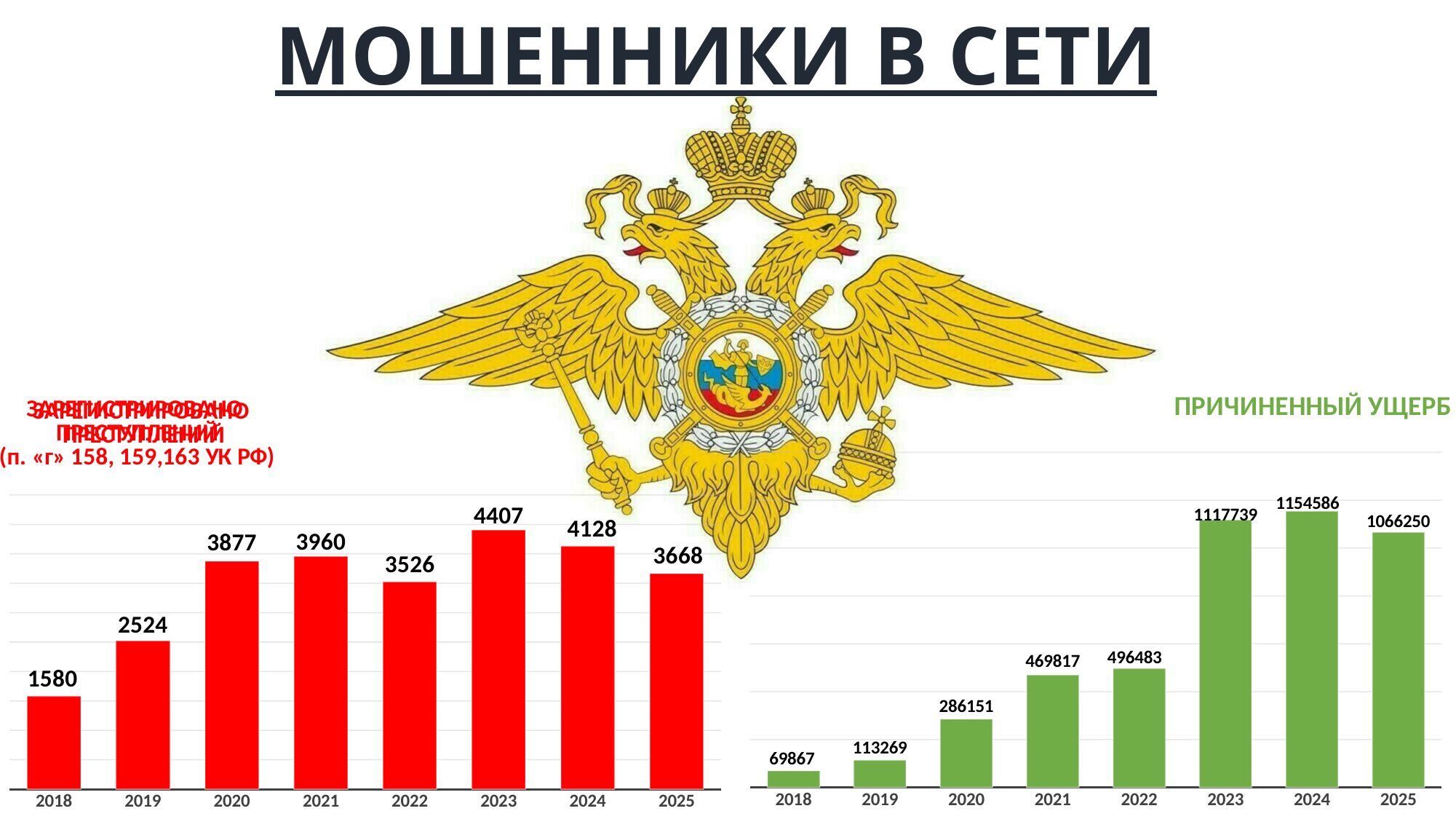
In the right chart titled ПРИЧИНЕННЫЙ УЩЕРБ, which is larger, the value for 2023 or the value for 2025? 2023 In the left chart with red bars, which year has the lowest value? 2018 In the right chart titled ПРИЧИНЕННЫЙ УЩЕРБ, which year has the highest value? 2024 What kind of chart is the right chart titled ПРИЧИНЕННЫЙ УЩЕРБ? bar chart What colour are the bars in the right chart titled ПРИЧИНЕННЫЙ УЩЕРБ? green How many years are shown on the x axis of the left chart with red bars? 8 In the right chart titled ПРИЧИНЕННЫЙ УЩЕРБ, do the values rise or fall from 2018 to 2024? rise In the left chart with red bars, what is the value for 2023? 4407 In the right chart titled ПРИЧИНЕННЫЙ УЩЕРБ, what is the value for 2024? 1154586 In the right chart titled ПРИЧИНЕННЫЙ УЩЕРБ, what is the difference between the values for 2019 and 2018? 43402 In the left chart with red bars, what is the difference between the values for 2023 and 2024? 279 In the left chart with red bars, which is larger, the value for 2020 or the value for 2022? 2020